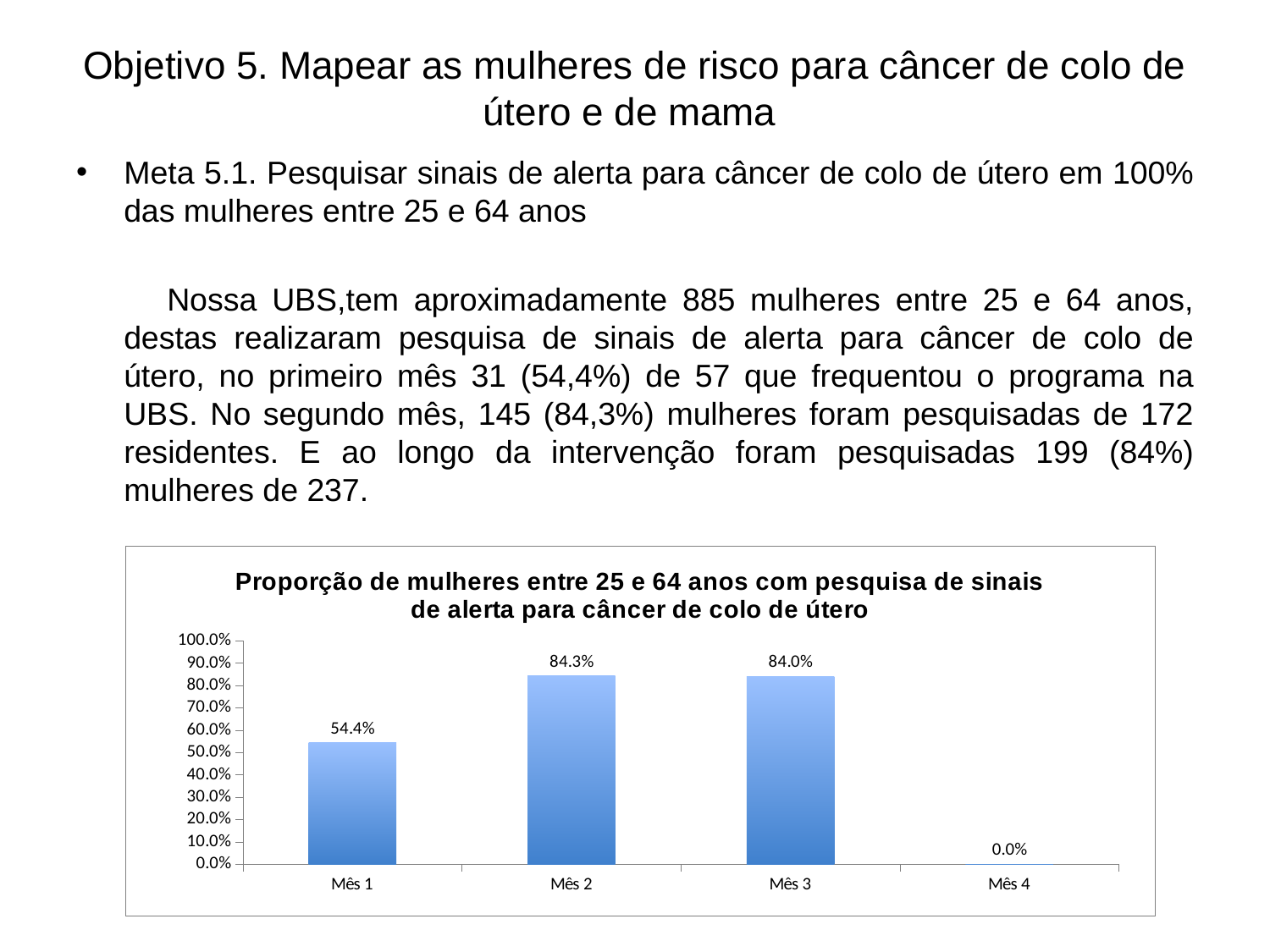
What is the value for Mês 4? 0.0% What is the value for Mês 3? 84.0% Which is larger, the value for Mês 1 or the value for Mês 3? Mês 3 What kind of chart is shown on the slide? Bar chart What is the value for Mês 2? 84.3% What is the difference between the values for Mês 2 and Mês 1? 29.9% Which month has the lowest value? Mês 4 How many months are shown on the x axis? 4 Is the value for Mês 1 greater or less than 50.0%? greater What is the value for Mês 1? 54.4% What is the title of the chart? Proporção de mulheres entre 25 e 64 anos com pesquisa de sinais de alerta para câncer de colo de útero Which month has the highest value? Mês 2